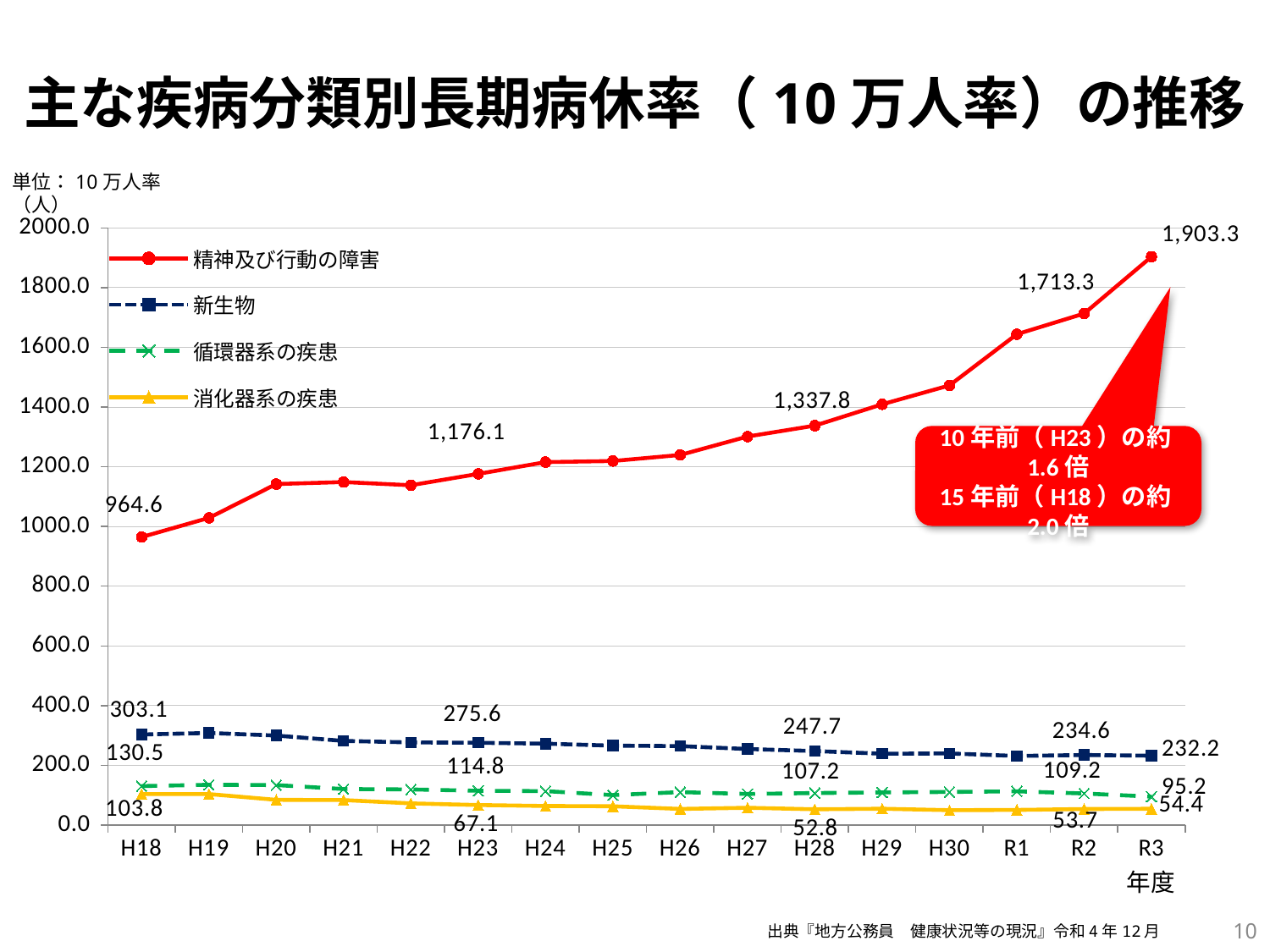
Which series has the highest value in R3? 精神及び行動の障害 What is the difference between the 精神及び行動の障害 values in R3 and R2? 190.0 How many series does the legend list? 4 Does the 精神及び行動の障害 series generally rise or fall from H18 to R3? rise Is the value for 精神及び行動の障害 in H30 greater or less than 1400.0? greater What is the value for 循環器系の疾患 in R2? 109.2 Which is larger: the 新生物 value in H18 or in R3? H18 What is the value for 精神及び行動の障害 in H18? 964.6 What is the value for 消化器系の疾患 in H28? 52.8 What is the value for 新生物 in H23? 275.6 Which series has the lowest value in H23? 消化器系の疾患 What is the value for 精神及び行動の障害 in R3? 1,903.3